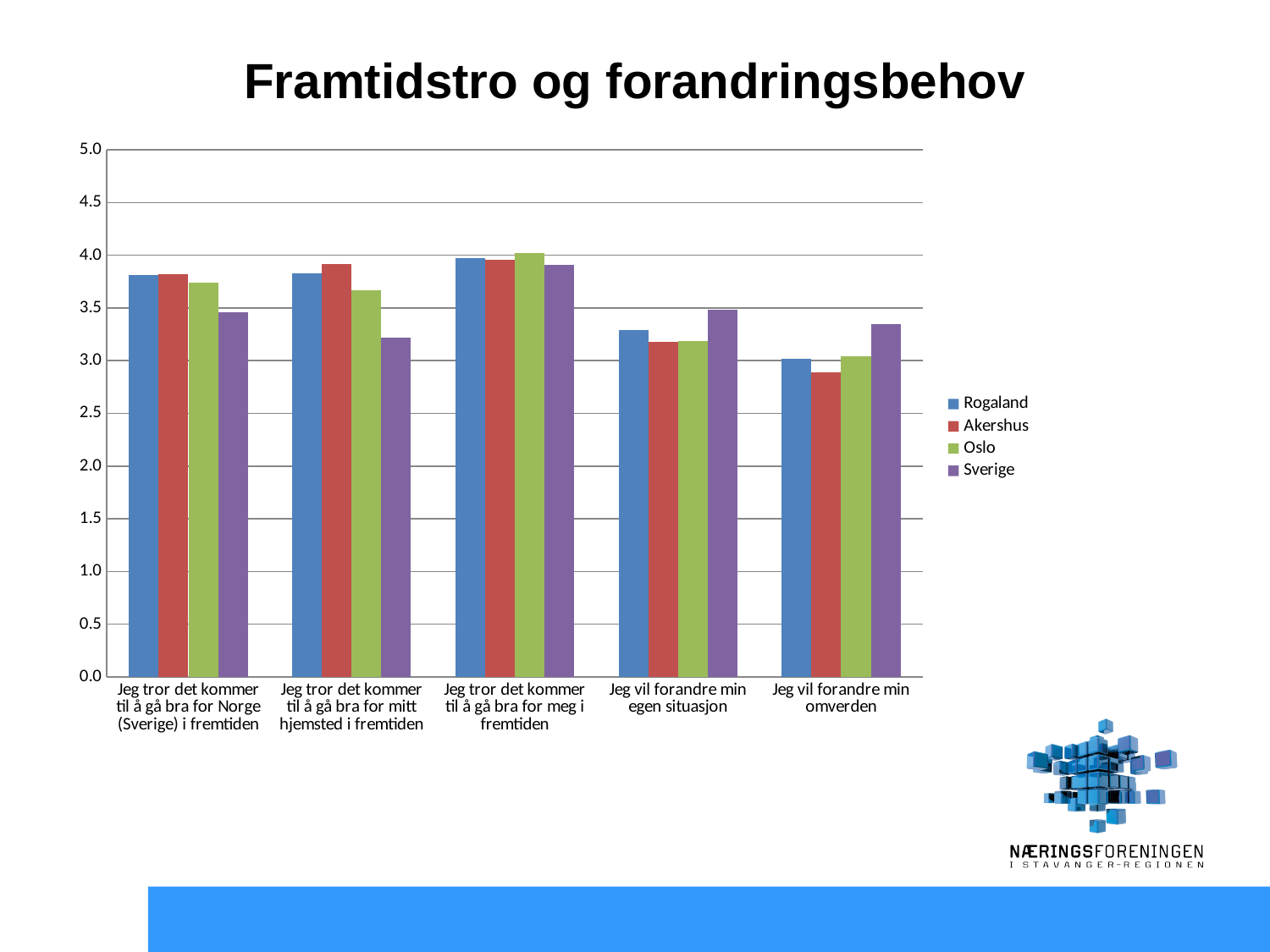
What colour are the bars for Sverige? purple Is the value for Sverige in the category 'Jeg tror det kommer til å gå bra for mitt hjemsted i fremtiden' greater or less than 3.5? less Is the value for Rogaland in the category 'Jeg vil forandre min egen situasjon' greater or less than 3.0? greater In the category 'Jeg tror det kommer til å gå bra for mitt hjemsted i fremtiden', which is larger: Rogaland or Sverige? Rogaland How many categories are shown along the x axis? 5 Which series has the lowest value in the category 'Jeg tror det kommer til å gå bra for mitt hjemsted i fremtiden'? Sverige Is the value for Akershus in the category 'Jeg vil forandre min omverden' greater or less than 3.0? less Which series has the highest value in the category 'Jeg vil forandre min omverden'? Sverige In the category 'Jeg vil forandre min egen situasjon', which is larger: Akershus or Sverige? Sverige How many series does the legend list? 4 What type of chart is shown on the slide? bar chart